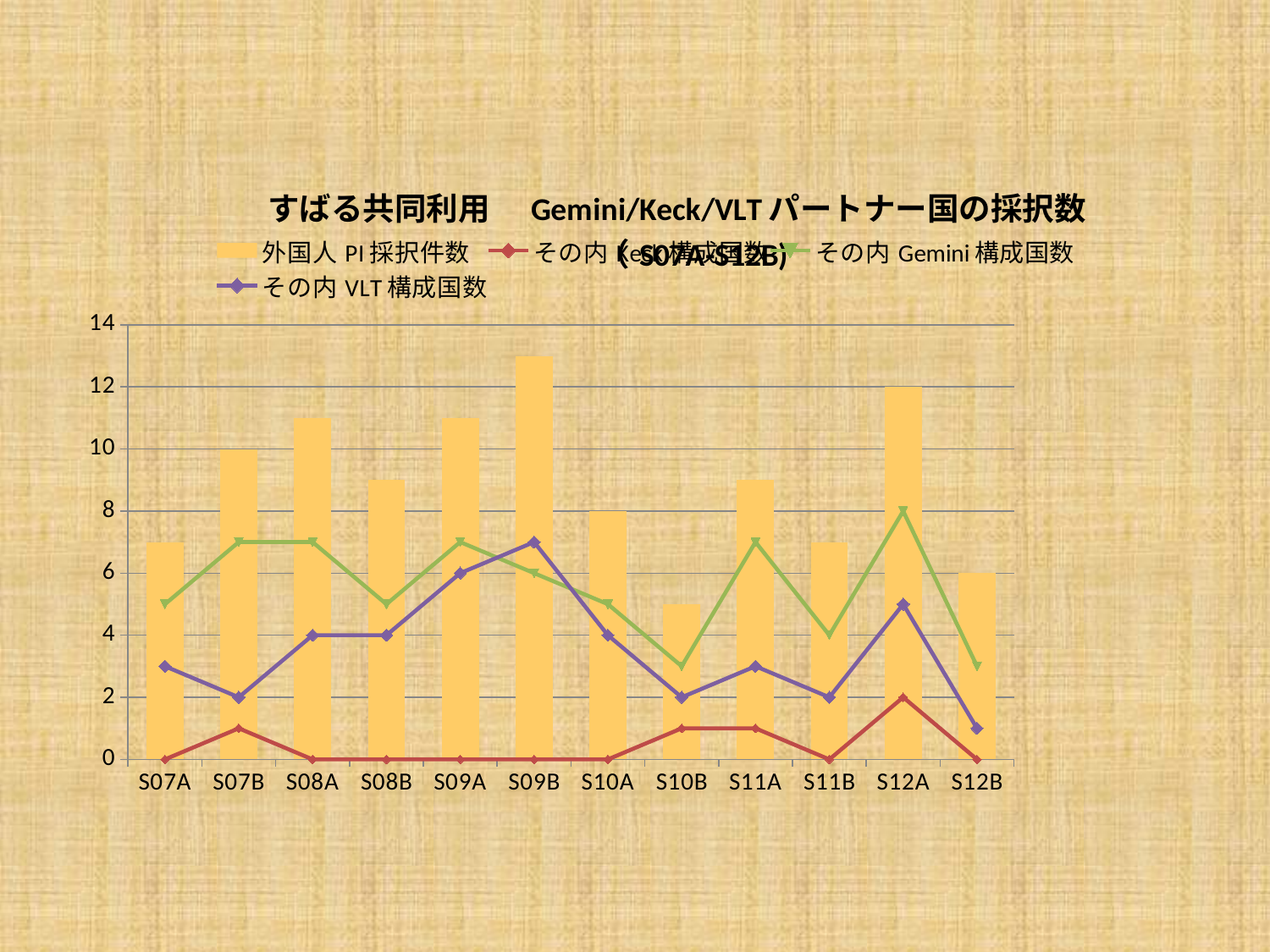
How many semesters (categories) are shown along the x axis? 12 How many series does the legend list? 4 What kind of chart is shown on the slide? A combined bar and line chart Which semester has the lowest 外国人 PI 採択件数 bar? S10B Does the その内 Gemini 構成国数 line rise or fall from S12A to S12B? fall Is the 外国人 PI 採択件数 bar for S09B greater or less than 12? greater What is the value of the その内 Gemini 構成国数 line at S12A? 8 What is the value of the 外国人 PI 採択件数 bar for S07B? 10 What is the value of the その内 VLT 構成国数 line at S09A? 6 Which semester has the highest 外国人 PI 採択件数 bar? S09B Which is larger, the 外国人 PI 採択件数 bar for S08A or for S10A? S08A What is the value of the 外国人 PI 採択件数 bar for S12A? 12